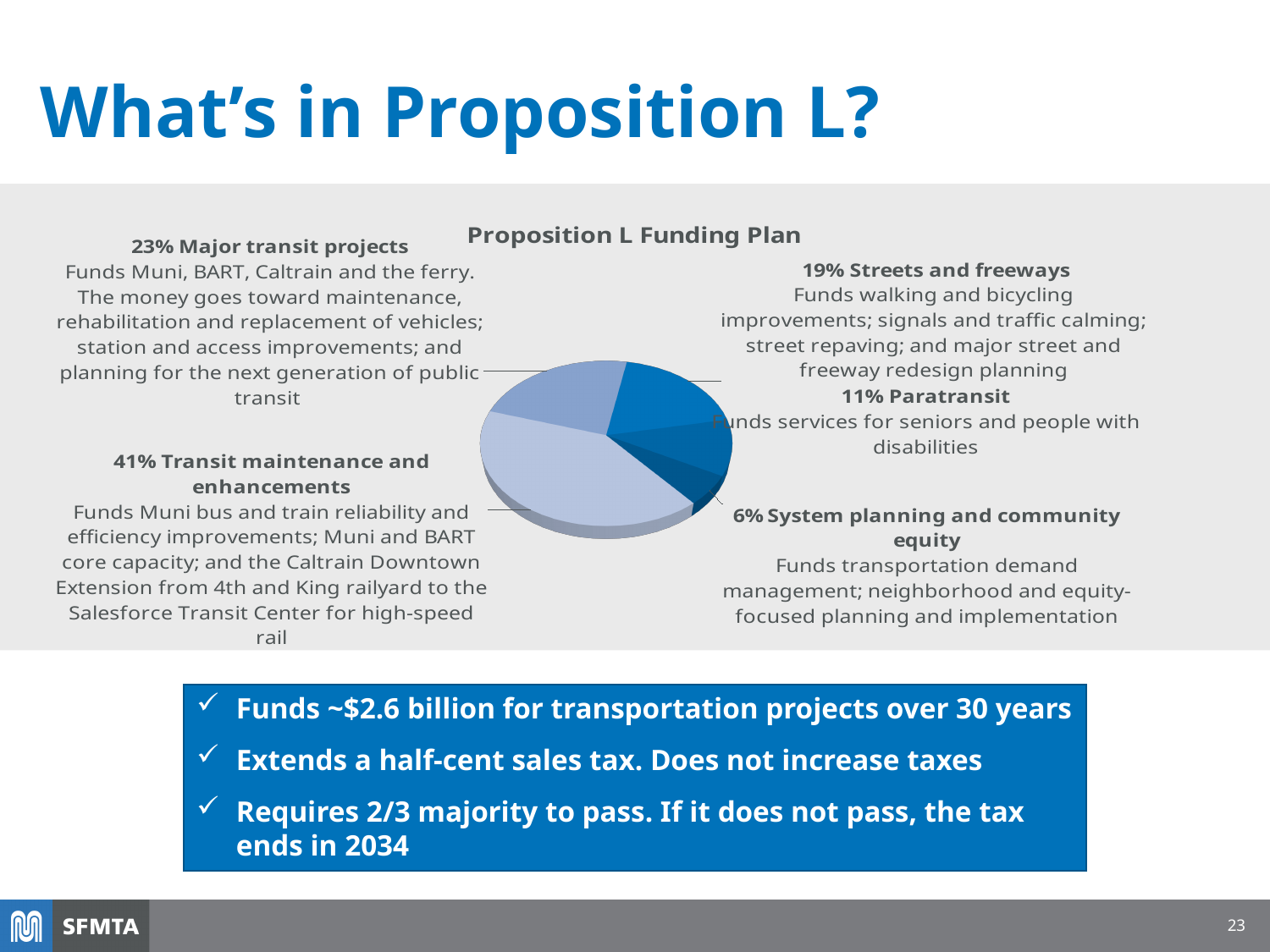
What share of the Proposition L Funding Plan goes to System planning and community equity? 6% What share of the Proposition L Funding Plan goes to Paratransit? 11% What share of the Proposition L Funding Plan goes to Major transit projects? 23% How many slices does the pie chart have? 5 What is the title of the chart? Proposition L Funding Plan Which category receives the largest share of the Proposition L Funding Plan? Transit maintenance and enhancements Which category receives the smallest share of the Proposition L Funding Plan? System planning and community equity What kind of chart is shown on the slide? Pie chart Which receives a larger share: Streets and freeways or Paratransit? Streets and freeways What is the difference in percentage points between the Transit maintenance and enhancements share and the Major transit projects share? 18